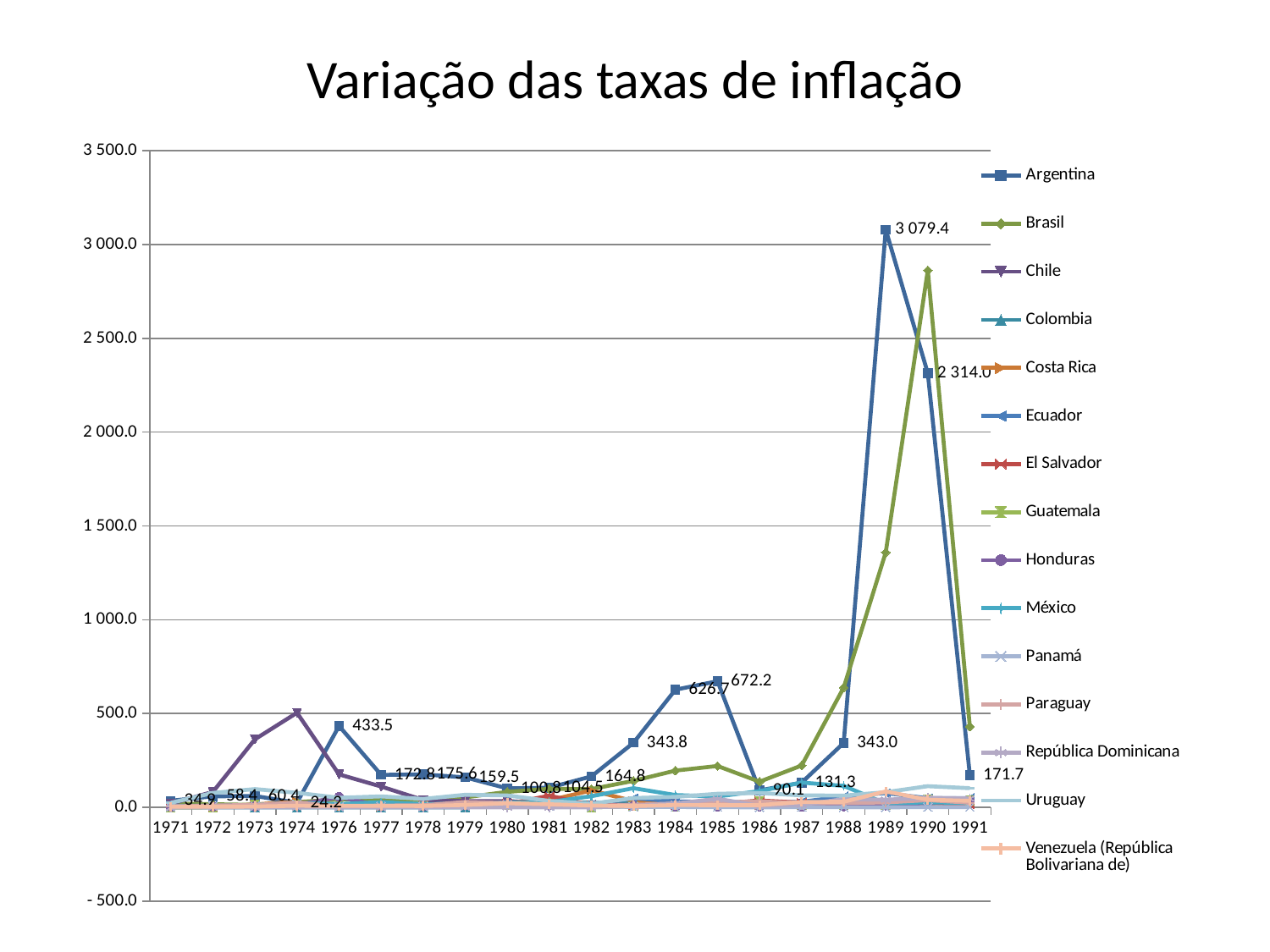
What kind of chart is shown on the slide? line chart What is the difference between Argentina's values in 1989 and 1990? 765.4 Is the value for Chile in 1973 greater or less than 500.0? less What is the value for Argentina in 1976? 433.5 Is the value for Brasil in 1990 greater or less than 2 500.0? greater In which year does Argentina have its lowest labelled value? 1974 In which year does Argentina reach its highest value? 1989 What is the value for Argentina in 1990? 2 314.0 What is the value for Argentina in 1991? 171.7 What is the value for Argentina in 1989? 3 079.4 Which is larger for Argentina, the value in 1984 or in 1985? 1985 How many series does the legend list? 15